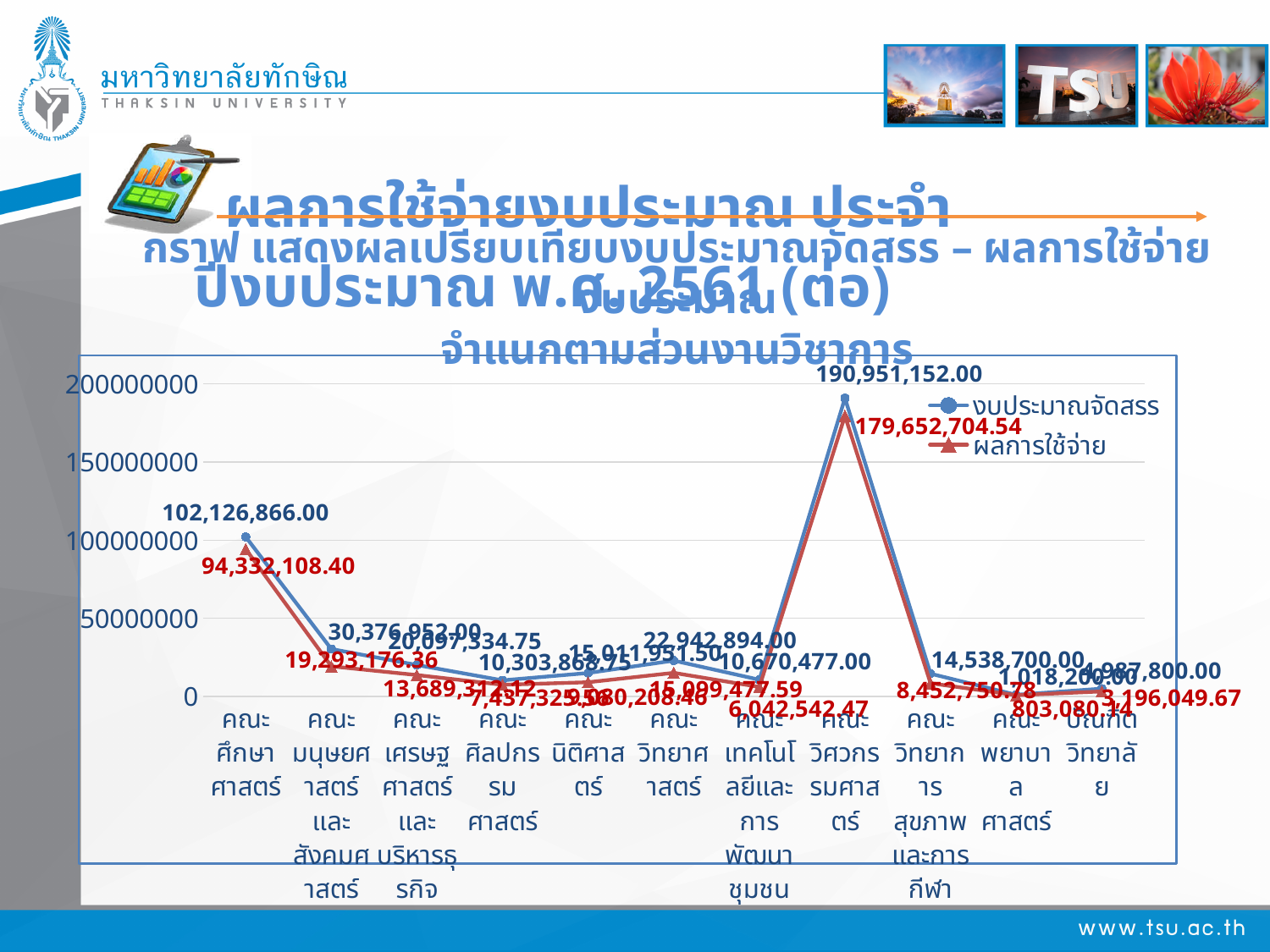
Which series is drawn in red with triangle markers? ผลการใช้จ่าย What is the ผลการใช้จ่าย value for คณะวิศวกรรมศาสตร์? 179,652,704.54 How many series does the legend list? 2 What is the งบประมาณจัดสรร value for คณะวิศวกรรมศาสตร์? 190,951,152.00 What is the งบประมาณจัดสรร value for คณะศึกษาศาสตร์? 102,126,866.00 Is the งบประมาณจัดสรร value for คณะศึกษาศาสตร์ greater or less than 100000000? greater What is the difference between งบประมาณจัดสรร and ผลการใช้จ่าย for คณะวิศวกรรมศาสตร์? 11,298,447.46 What kind of chart is shown on the slide? Line chart How many academic units (categories) are plotted on the x axis? 11 Which academic unit has the lowest ผลการใช้จ่าย? คณะพยาบาลศาสตร์ What is the ผลการใช้จ่าย value for คณะศึกษาศาสตร์? 94,332,108.40 Which academic unit has the highest งบประมาณจัดสรร? คณะวิศวกรรมศาสตร์